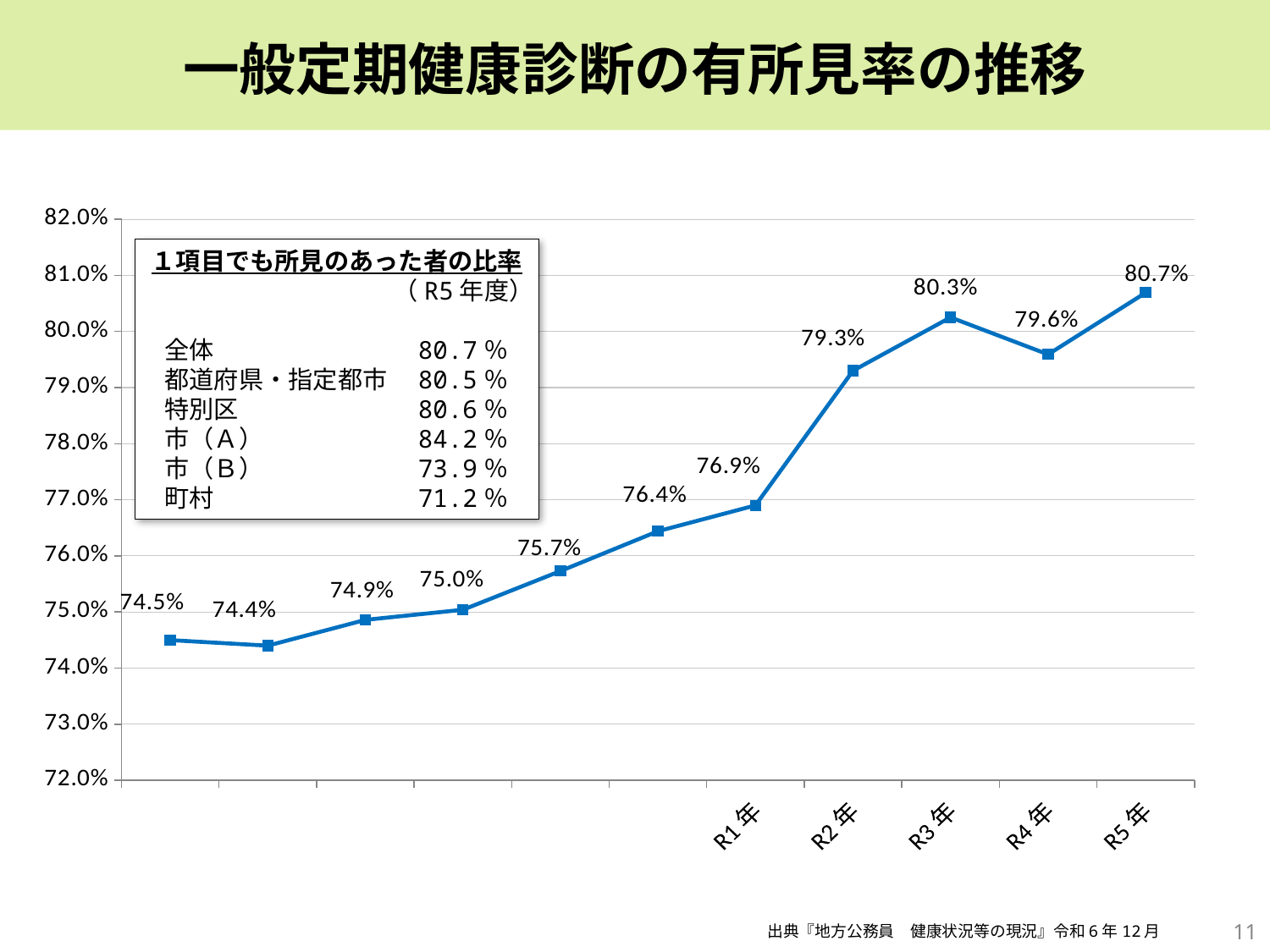
Do the values generally rise or fall from left to right along the x axis? rise What is the value plotted for R4年? 79.6% What is the value plotted for R5年? 80.7% What is the value plotted for R3年? 80.3% Which labelled year has the highest value on the chart? R5年 How many data points are plotted on the line? 11 What kind of chart is shown on the slide? line chart Which is larger, the value for R3年 or the value for R4年? R3年 What is the lowest value plotted on the chart? 74.4% What is the difference between the values for R5年 and R1年? 3.8 percentage points What is the title of the slide? 一般定期健康診断の有所見率の推移 What is the value plotted for R1年? 76.9%